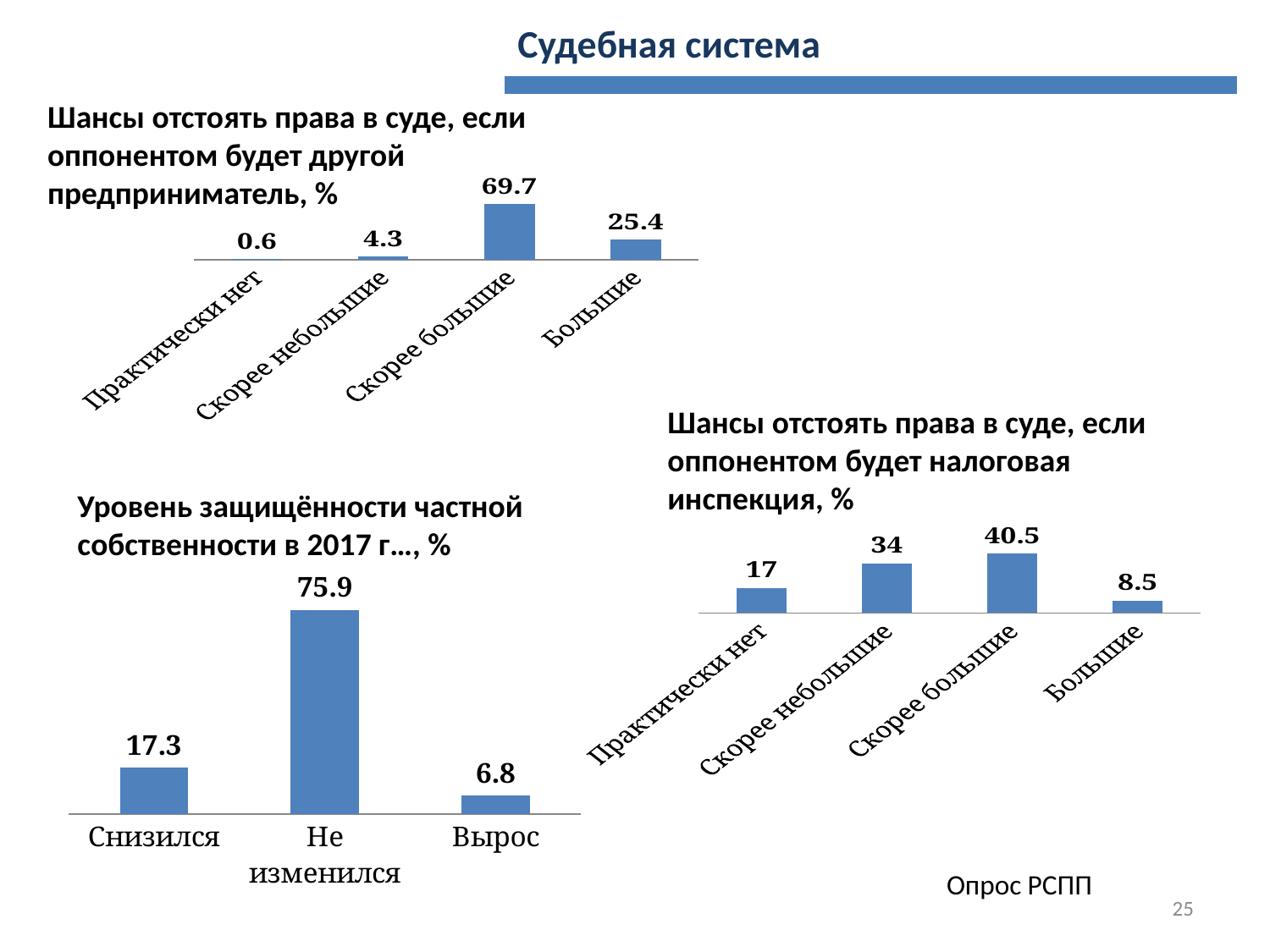
In the chart 'Шансы отстоять права в суде, если оппонентом будет другой предприниматель, %', which category has the lowest value? Практически нет In the chart 'Шансы отстоять права в суде, если оппонентом будет налоговая инспекция, %', which category has the highest value? Скорее большие In the chart 'Шансы отстоять права в суде, если оппонентом будет налоговая инспекция, %', what is the difference between 'Практически нет' and 'Большие'? 8.5 In the chart 'Шансы отстоять права в суде, если оппонентом будет другой предприниматель, %', what is the difference between 'Скорее большие' and 'Большие'? 44.3 What type of chart is 'Уровень защищённости частной собственности в 2017 г…, %'? Bar chart In the chart 'Уровень защищённости частной собственности в 2017 г…, %', which category has the highest value? Не изменился How many charts are shown on the slide? 3 How many categories are shown in the chart 'Шансы отстоять права в суде, если оппонентом будет другой предприниматель, %'? 4 In the chart 'Уровень защищённости частной собственности в 2017 г…, %', what is the value for 'Снизился'? 17.3 In the chart 'Шансы отстоять права в суде, если оппонентом будет другой предприниматель, %', what is the value for 'Скорее большие'? 69.7 In the chart 'Шансы отстоять права в суде, если оппонентом будет налоговая инспекция, %', what is the value for 'Скорее небольшие'? 34 In the chart 'Уровень защищённости частной собственности в 2017 г…, %', which is larger: 'Снизился' or 'Вырос'? Снизился